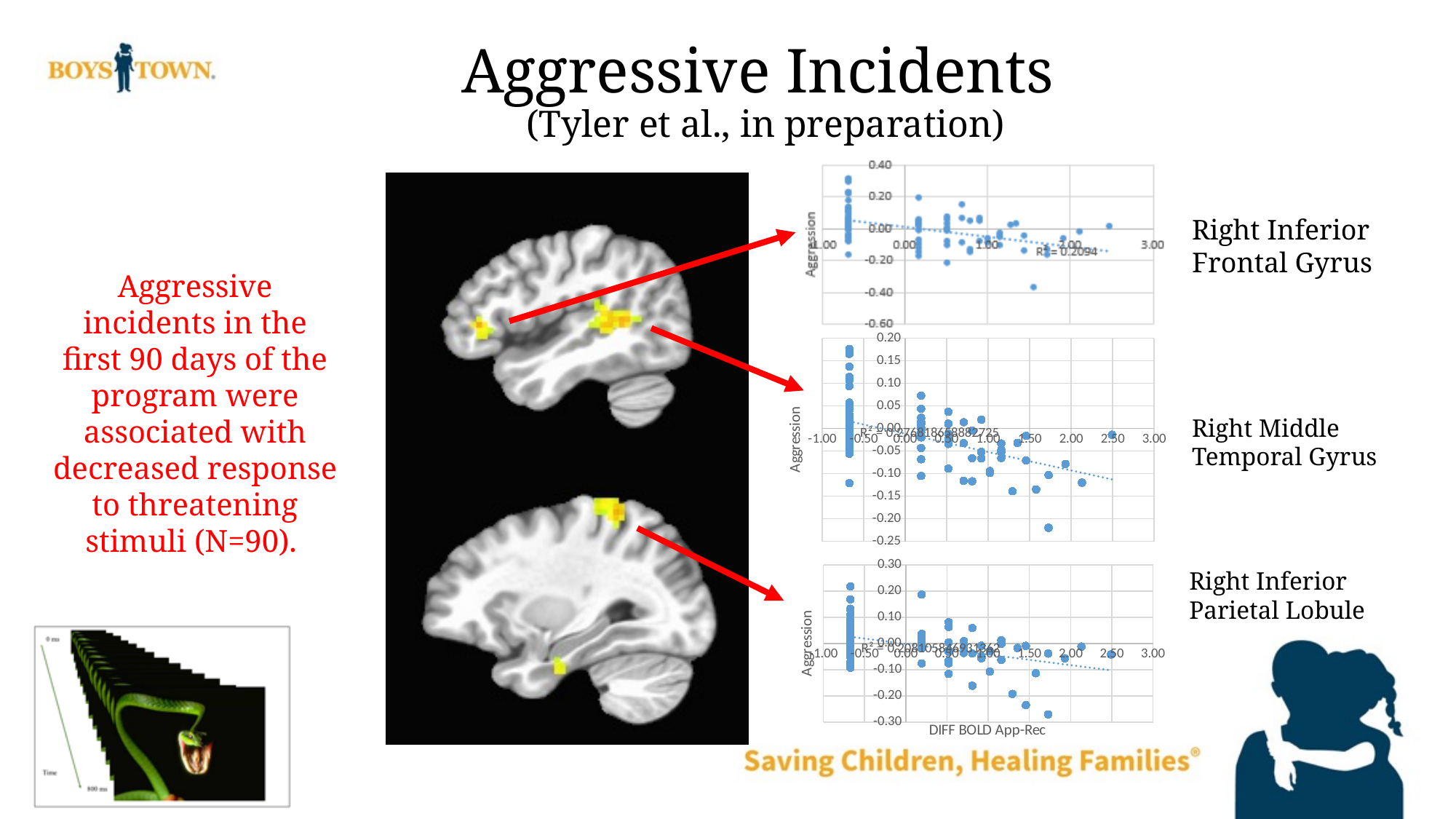
What is the label on the x-axis of the bottom chart (Right Inferior Parietal Lobule)? DIFF BOLD App-Rec What is the highest tick value shown on the y-axis of the top chart (Right Inferior Frontal Gyrus)? 0.40 In the top chart (Right Inferior Frontal Gyrus), what R-squared value is printed next to the trend line? R² = 0.2094 In the bottom chart (Right Inferior Parietal Lobule), does the trend line rise or fall from left to right? fall In the top chart (Right Inferior Frontal Gyrus), is the lowest plotted point greater or less than -0.20 on the y-axis? less In the middle chart (Right Middle Temporal Gyrus), is the highest plotted point greater or less than 0.10 on the y-axis? greater What is the label on the y-axis of the middle chart (Right Middle Temporal Gyrus)? Aggression What kind of chart is the top chart labelled Right Inferior Frontal Gyrus? scatter chart How many scatter charts are shown on the slide? 3 In the bottom chart (Right Inferior Parietal Lobule), is the lowest plotted point greater or less than -0.20 on the y-axis? less In the top chart (Right Inferior Frontal Gyrus), does the trend line rise or fall as the x-axis values increase? fall In the middle chart (Right Middle Temporal Gyrus), does the trend line rise or fall from left to right? fall